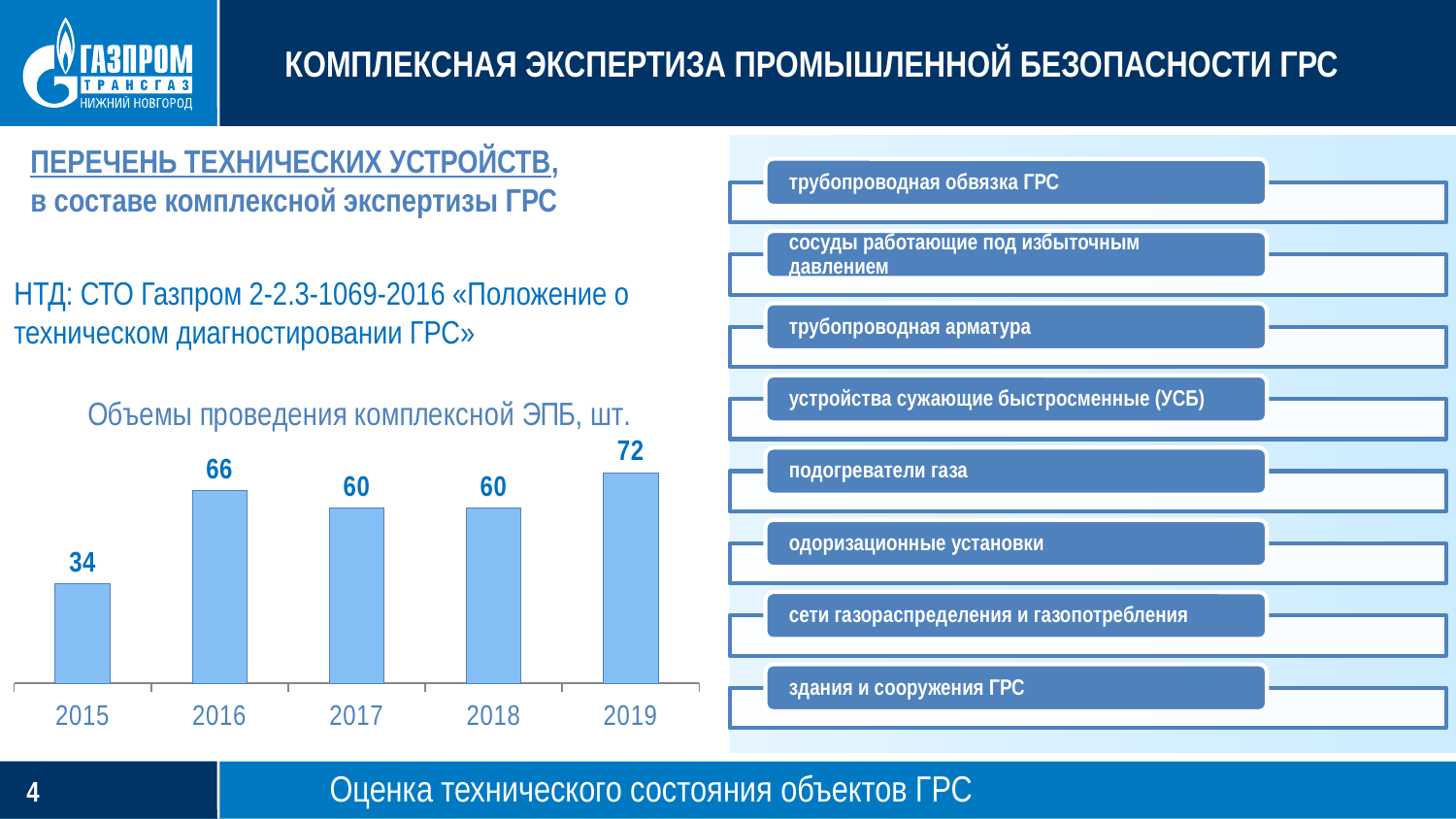
What is the title of the chart on the slide? Объемы проведения комплексной ЭПБ, шт. What is the difference between the values for 2016 and 2017? 6 Which year has the lowest value in the chart? 2015 What is the value for 2015 in the chart "Объемы проведения комплексной ЭПБ, шт."? 34 Which year has the highest value in the chart? 2019 What is the value for 2016 in the chart? 66 Which is larger, the value for 2016 or the value for 2018? 2016 How many years (categories) are shown on the x axis of the chart? 5 What is the difference between the values for 2019 and 2015? 38 What kind of chart is shown on the slide? Bar chart What is the value for 2019 in the chart? 72 Do the values for 2017 and 2018 differ, or are they equal? Equal